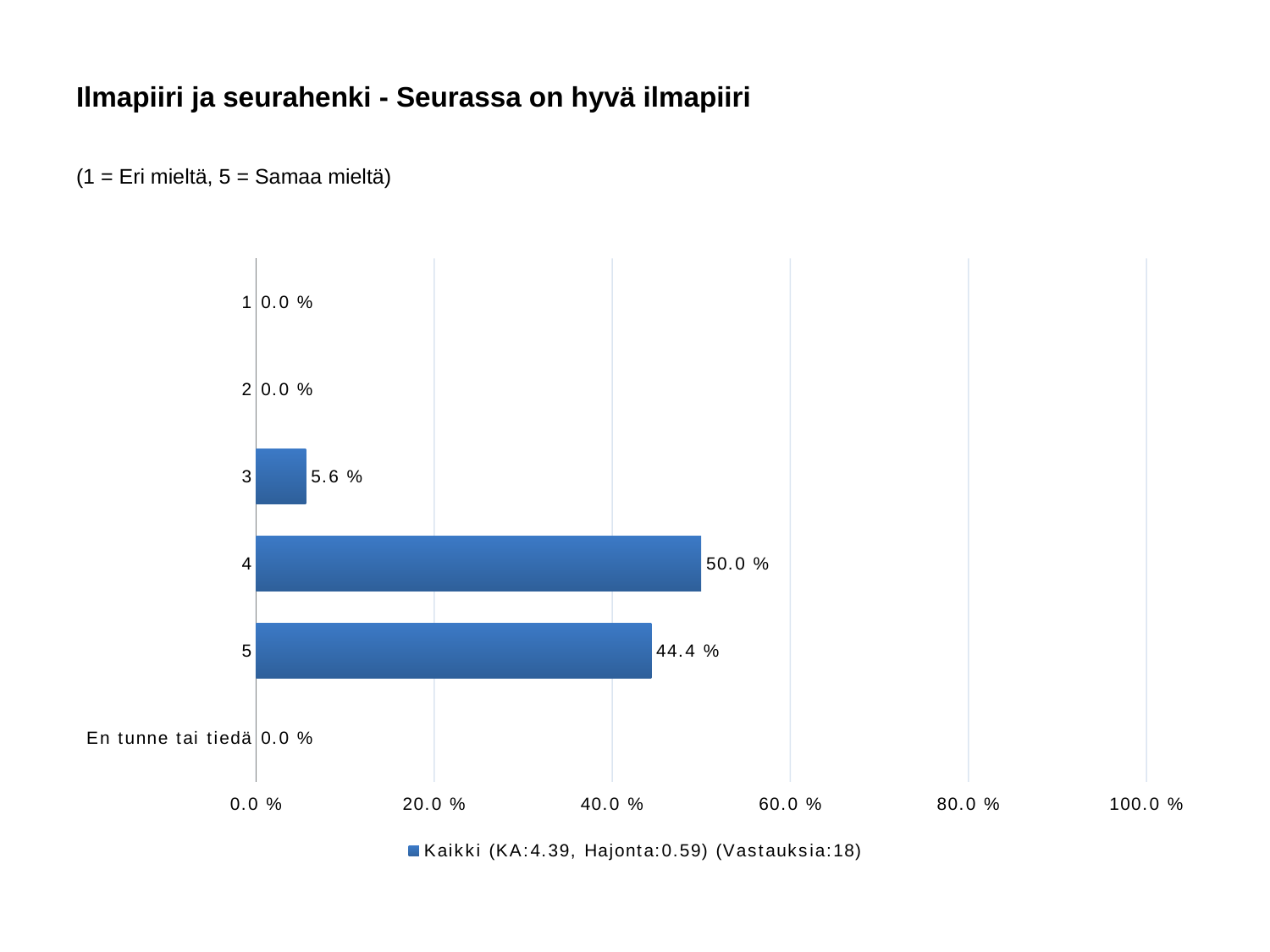
Which category has the highest value? 4 What is the value for category 4? 50.0 % What is the title of the chart? Ilmapiiri ja seurahenki - Seurassa on hyvä ilmapiiri Is the value for category 5 greater or less than 40.0 %? greater How many categories are shown on the y axis? 6 What is the value for category 3? 5.6 % What is the difference between the values for category 4 and category 5? 5.6 % What kind of chart is shown? bar chart Which is larger, the value for category 3 or the value for category 5? 5 How many series does the legend list? 1 What is the value for 'En tunne tai tiedä'? 0.0 % What is the value for category 5? 44.4 %